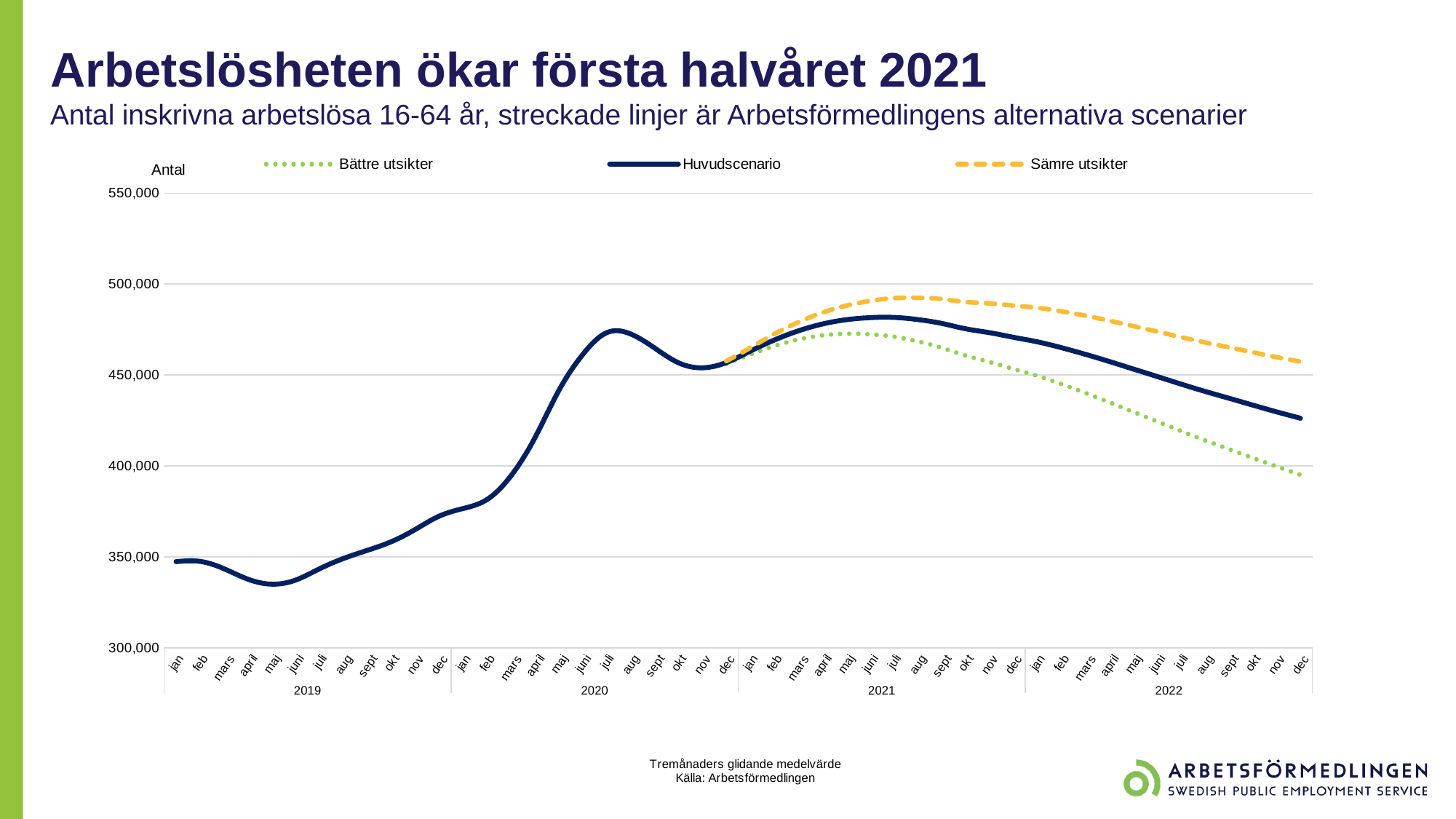
Is the value for Huvudscenario in May 2019 greater or less than 350,000? less Does the Huvudscenario line rise or fall over the course of 2022? fall How many years are labelled along the x axis? 4 Which series is drawn as a solid dark blue line? Huvudscenario Is the peak value of Sämre utsikter greater or less than 500,000? less How many series does the legend list? 3 Which series is drawn as a yellow dashed line? Sämre utsikter Is the value for Sämre utsikter in December 2022 greater or less than 450,000? greater In December 2022, which series has the higher value, Sämre utsikter or Bättre utsikter? Sämre utsikter What kind of chart is shown on the slide? line chart